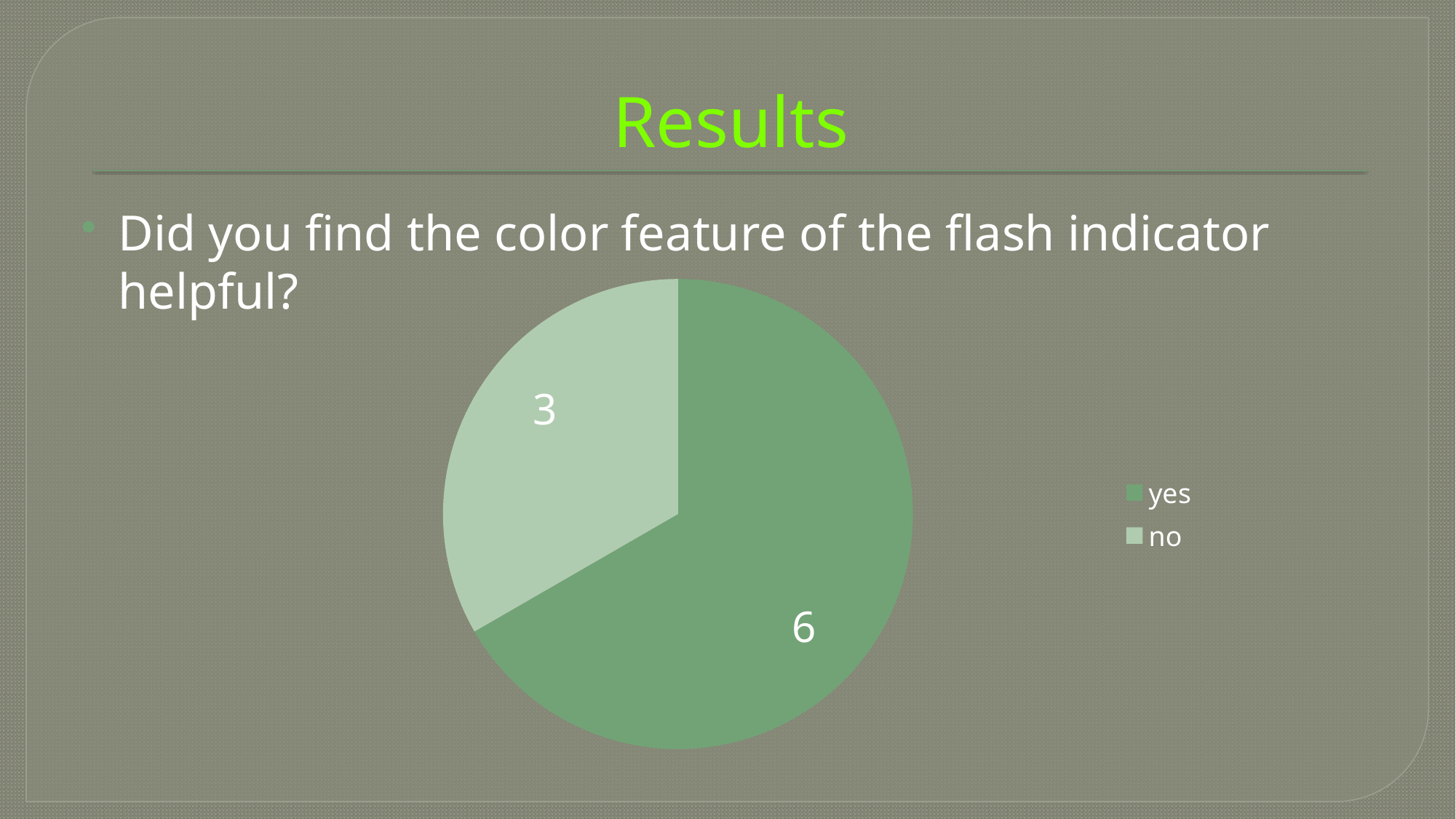
What share of the pie does the "no" slice represent? 1/3 Which is larger, the value for "yes" or the value for "no"? yes What is the difference between the "yes" and "no" values? 3 Which category has the smallest slice in the pie chart? no Which legend entry is shown in the lighter green colour? no What is the total of all slices in the pie chart? 9 What kind of chart is shown on the slide? pie chart What is the value for "no" in the pie chart? 3 What is the value for "yes" in the pie chart? 6 Which category has the largest slice in the pie chart? yes How many categories does the pie chart have? 2 How many entries does the legend list? 2